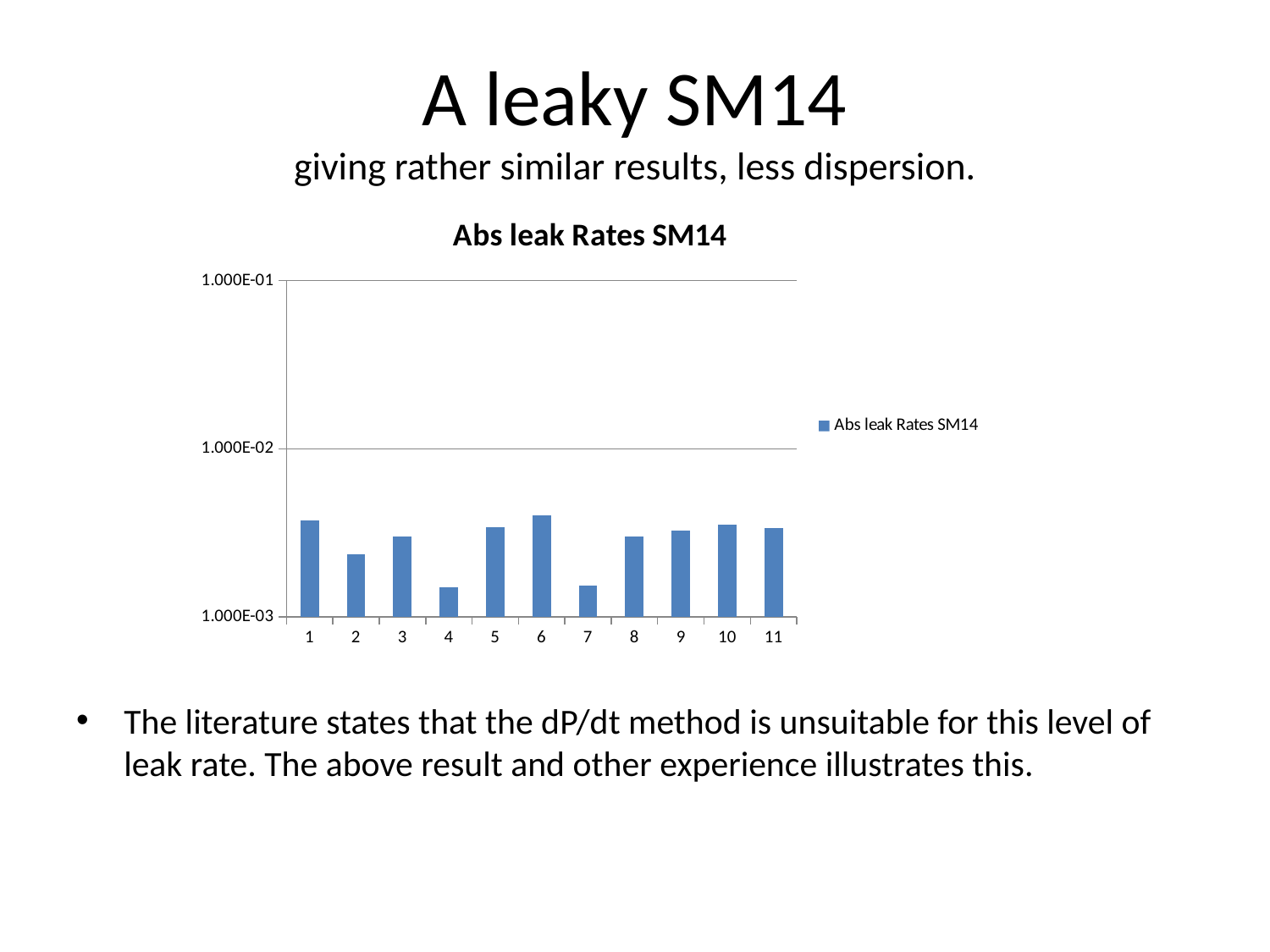
What type of chart is shown on the slide? bar chart Is the value for category 6 greater or less than 1.000E-02? less How many categories are plotted along the x axis? 11 Which is larger, the value for category 4 or category 5? category 5 Which category has the highest bar? 6 Which is larger, the value for category 1 or category 2? category 1 Is the value for category 1 greater or less than 1.000E-03? greater What is the title of the chart? Abs leak Rates SM14 What is the name of the series shown in the legend? Abs leak Rates SM14 Which is larger, the value for category 6 or category 7? category 6 How many series does the legend list? 1 Is the value for category 4 greater or less than 1.000E-02? less